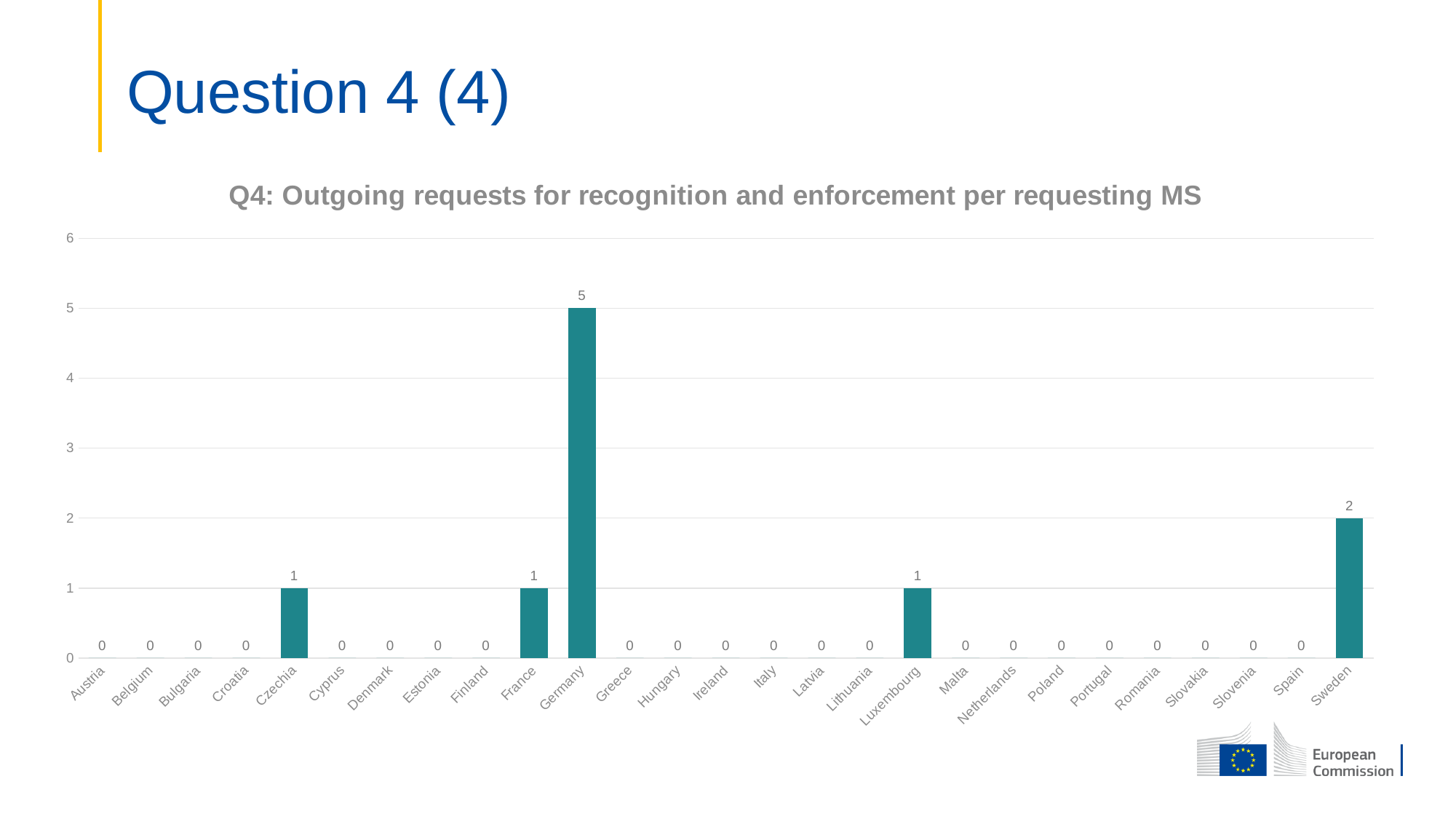
Which is larger, the value for Sweden or the value for France? Sweden How many countries are shown on the x axis? 27 What is the value for Spain? 0 What is the difference between the values for Germany and Sweden? 3 What kind of chart is shown? Bar chart What is the value for Luxembourg? 1 What is the title of the chart? Q4: Outgoing requests for recognition and enforcement per requesting MS Which country has the highest value? Germany What is the value for Germany? 5 Is the value for Germany greater or less than 4? greater How many countries have a value of 1? 3 What is the value for Sweden? 2